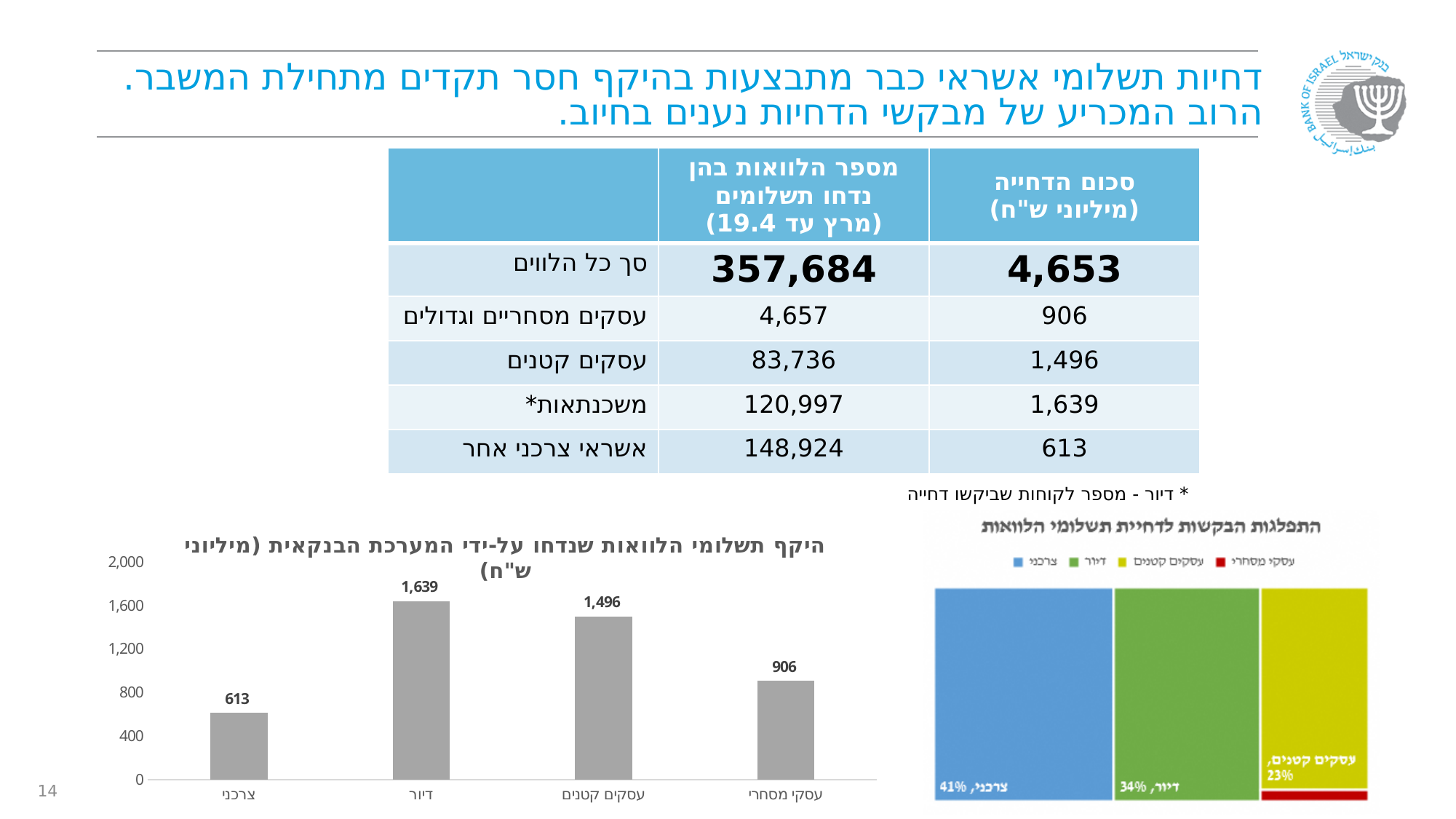
In the bar chart at the bottom left, what is the value for צרכני? 613 In the bar chart at the bottom left, what is the value for עסקים קטנים? 1,496 How many categories are shown in the bar chart at the bottom left? 4 In the chart titled "התפלגות הבקשות לדחיית תשלומי הלוואות" at the bottom right, what share is shown for צרכני? 41% In the bar chart at the bottom left, which category has the highest value? דיור In the chart titled "התפלגות הבקשות לדחיית תשלומי הלוואות" at the bottom right, how many entries does the legend list? 4 In the bar chart at the bottom left, which category has the lowest value? צרכני In the bar chart titled "היקף תשלומי הלוואות שנדחו על-ידי המערכת הבנקאית (מיליוני ש"ח)", what is the value for דיור? 1,639 In the bar chart at the bottom left, which is larger: the value for עסקים קטנים or the value for עסקי מסחרי? עסקים קטנים In the bar chart at the bottom left, is the value for עסקי מסחרי greater or less than 800? greater In the bar chart at the bottom left, what is the difference between the values for דיור and עסקי מסחרי? 733 What kind of chart is the chart at the bottom left of the slide? bar chart